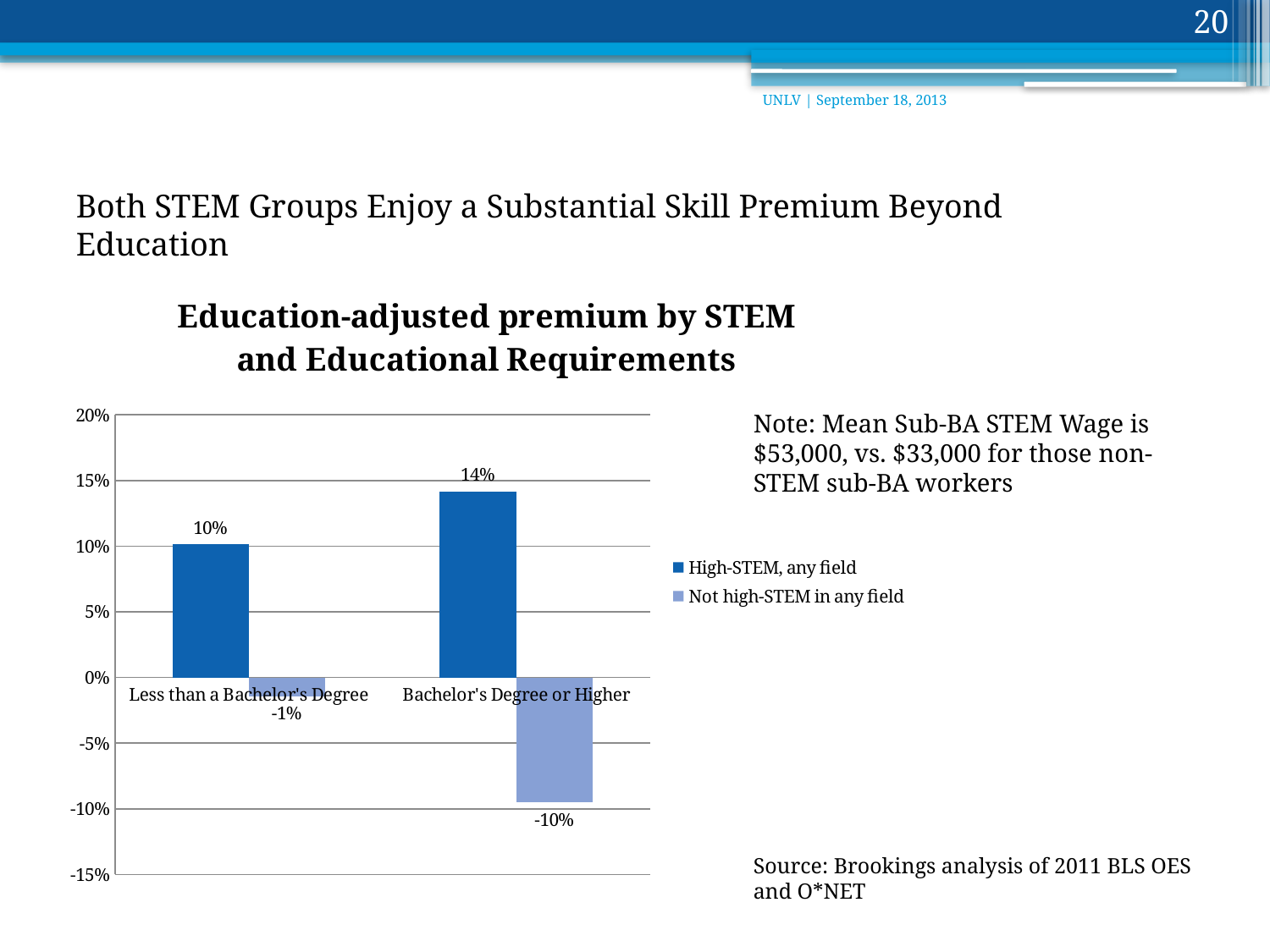
How many categories are shown on the x axis of the chart? 2 How many series does the legend list? 2 Which is larger: the High-STEM, any field value for Less than a Bachelor's Degree or for Bachelor's Degree or Higher? Bachelor's Degree or Higher What is the education-adjusted premium for High-STEM, any field among workers with Less than a Bachelor's Degree? 10% What is the title of the chart? Education-adjusted premium by STEM and Educational Requirements What is the value for Not high-STEM in any field among workers with Less than a Bachelor's Degree? -1% What is the value for Not high-STEM in any field among workers with a Bachelor's Degree or Higher? -10% Which category has the highest High-STEM, any field premium? Bachelor's Degree or Higher Which category has the lowest Not high-STEM in any field value? Bachelor's Degree or Higher What kind of chart is shown on the slide? Bar chart What is the education-adjusted premium for High-STEM, any field among workers with a Bachelor's Degree or Higher? 14% What is the difference between the High-STEM, any field premium for Bachelor's Degree or Higher and for Less than a Bachelor's Degree? 4%